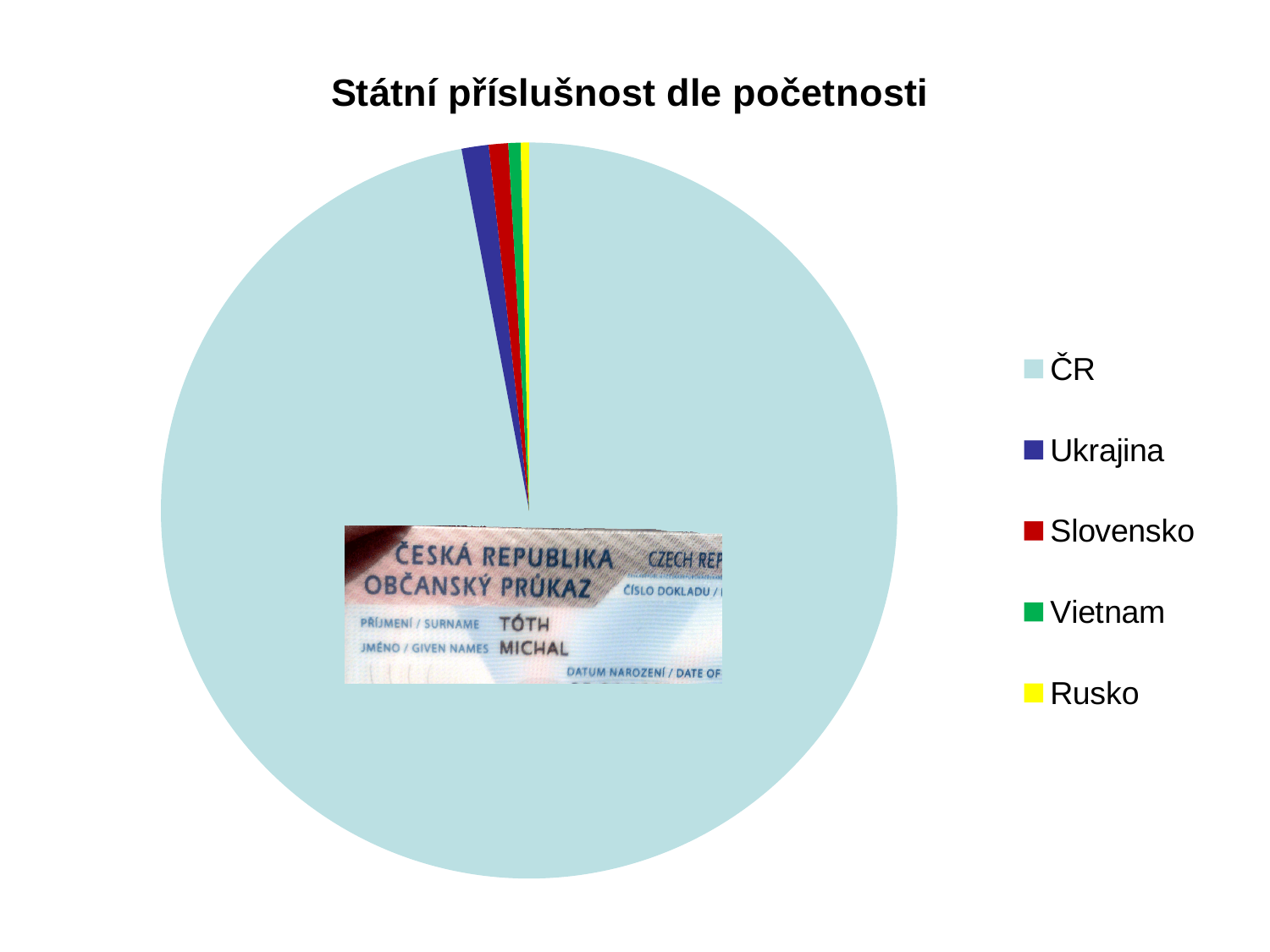
What is the title of the chart? Státní příslušnost dle početnosti Which is larger, the slice for Ukrajina or the slice for Slovensko? Ukrajina What kind of chart is shown on the slide? pie chart Which category has the largest slice of the pie? ČR Which category is shown in yellow in the legend? Rusko Which is larger, the slice for ČR or the slice for Ukrajina? ČR Which is larger, the slice for Ukrajina or the slice for Vietnam? Ukrajina How many categories does the pie chart have? 5 Which category is the largest among the non-ČR slices? Ukrajina